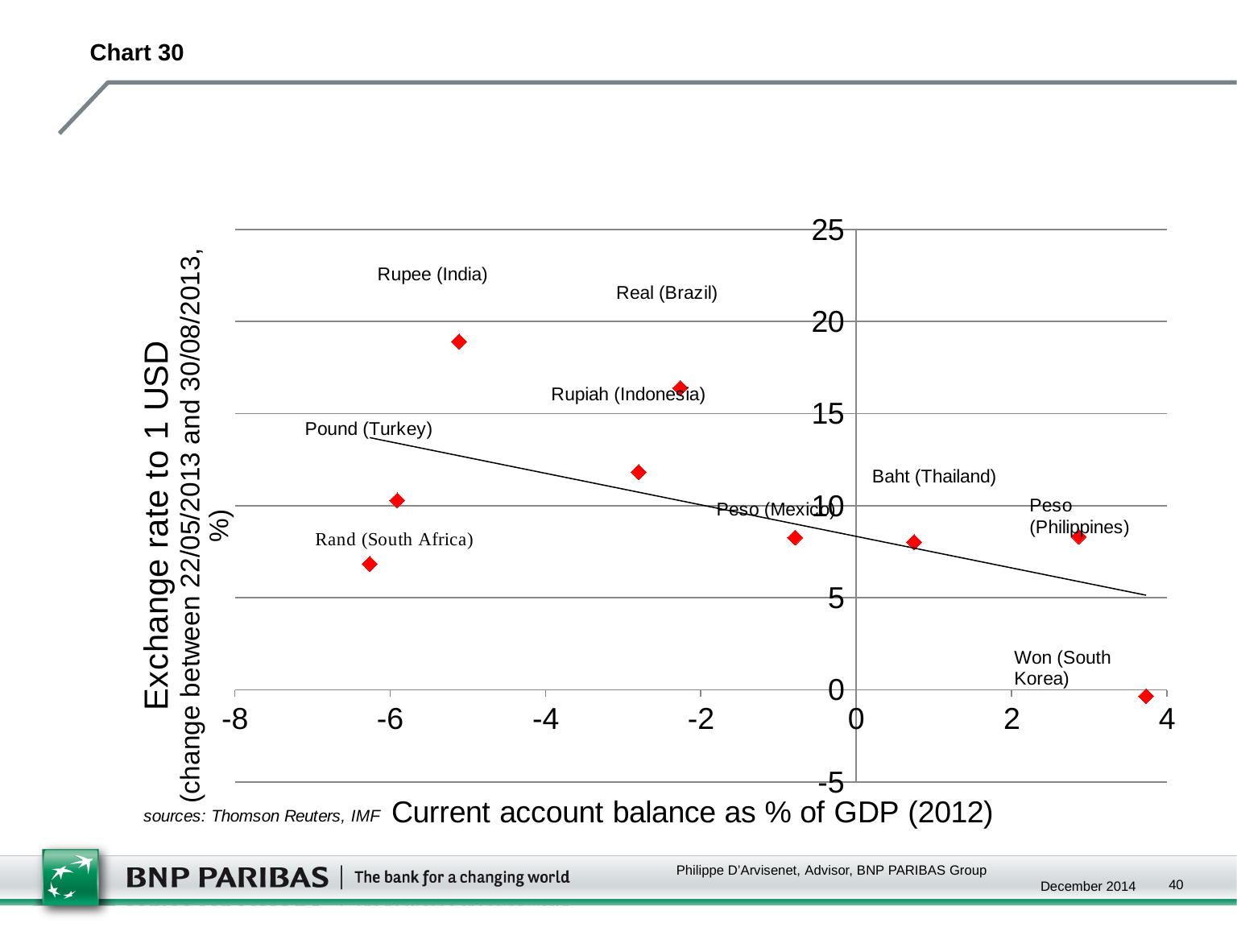
How many currencies are plotted as points on the chart? 9 Is the exchange rate change for the Peso (Mexico) greater or less than 10? less Is the exchange rate change for the Won (South Korea) greater or less than 5? less Which currency has the lowest exchange rate change against the USD? Won (South Korea) What is the title of the x axis? Current account balance as % of GDP (2012) What kind of chart is shown on the slide? scatter chart Is the exchange rate change for the Rupee (India) greater or less than 15? greater Which has a larger exchange rate change, the Rupee (India) or the Real (Brazil)? Rupee (India) Which currency has the highest exchange rate change against the USD? Rupee (India) Does the trend line show the exchange rate change rising or falling as the current account balance increases? falling Which has a larger exchange rate change, the Rupiah (Indonesia) or the Rand (South Africa)? Rupiah (Indonesia)